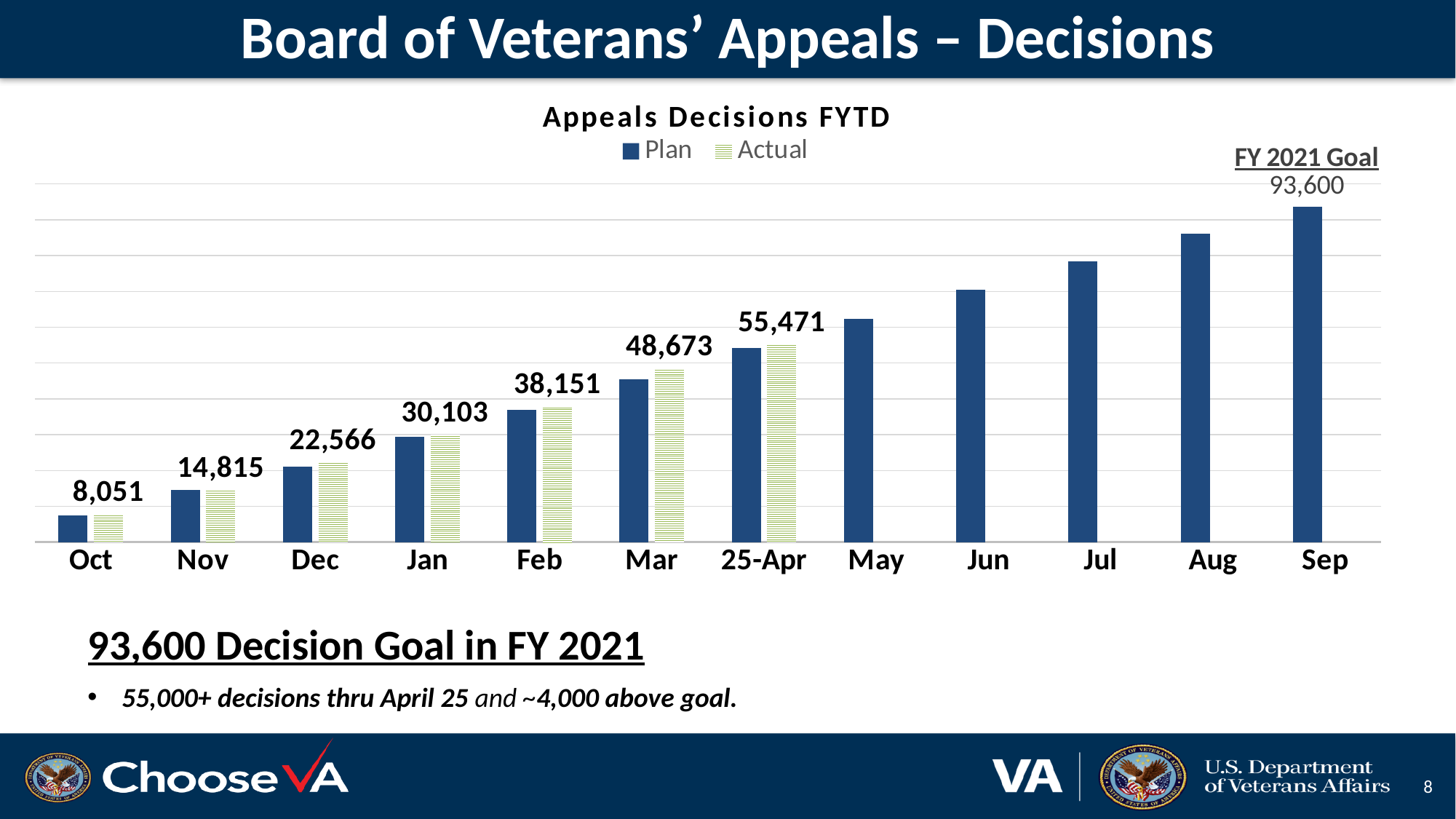
What is the FY 2021 Goal value shown above the Sep bar? 93,600 Which month has the highest labeled Actual value? 25-Apr How many series does the chart legend list? 2 How many categories are shown on the x axis of the chart? 12 What is the Actual value for Oct in the Appeals Decisions FYTD chart? 8,051 Which month has the lowest labeled Actual value? Oct Do the Plan values rise or fall from Oct to Sep? rise What is the Actual value labeled for 25-Apr? 55,471 What is the Actual value for Mar in the Appeals Decisions FYTD chart? 48,673 For Mar, which is larger, the Plan bar or the Actual bar? Actual What is the difference between the Actual values for Feb and Jan? 8,048 What is the difference between the Actual values for 25-Apr and Mar? 6,798